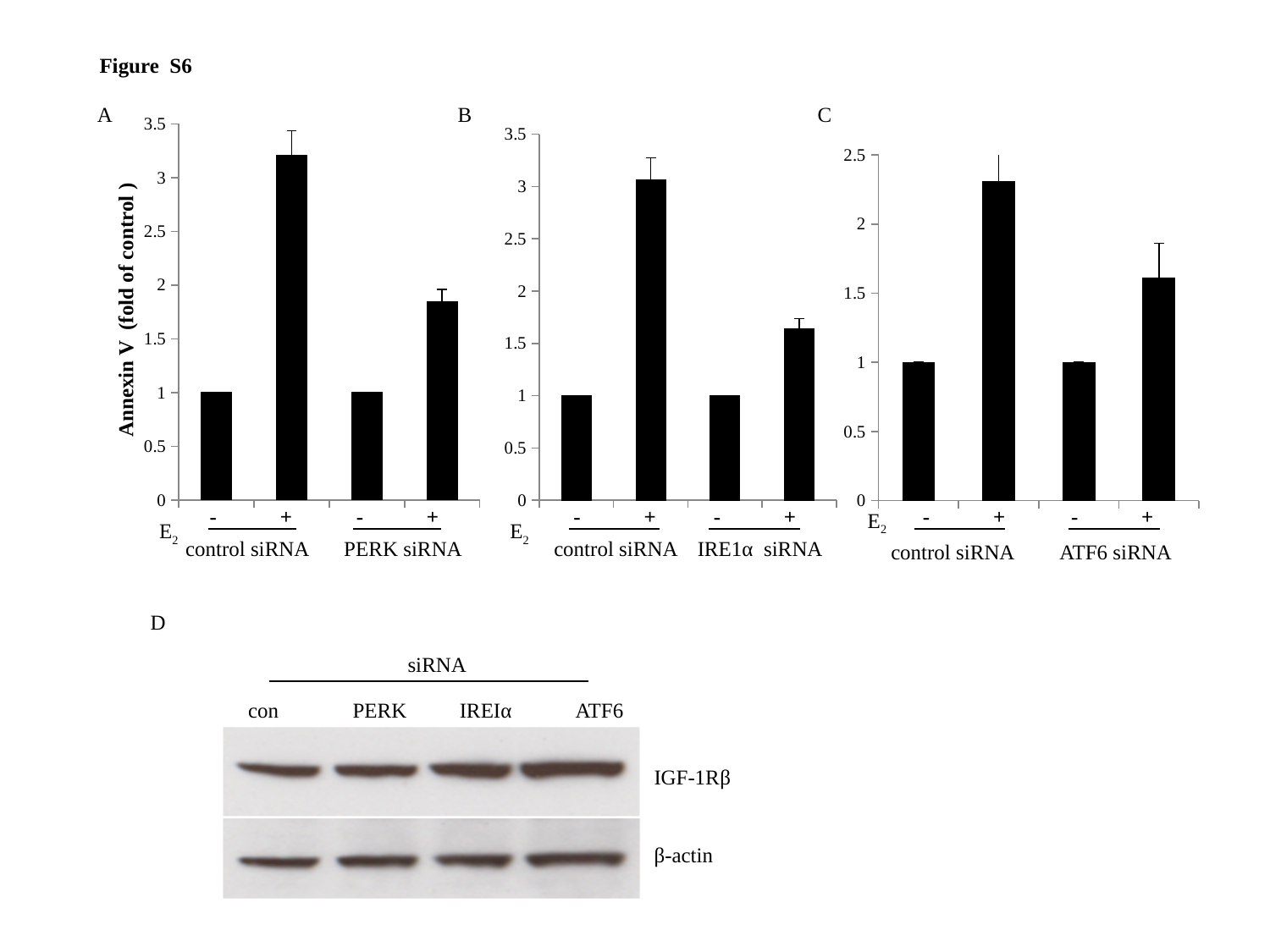
What kind of chart is chart A? bar chart In chart B, which is larger: the E2 + bar for control siRNA or the E2 + bar for IRE1α siRNA? control siRNA In chart C, is the value for ATF6 siRNA with E2 + greater or less than 2? less In chart A, is the value for PERK siRNA with E2 + greater or less than 2? less In chart C, what is the value for control siRNA with E2 -? 1 In chart A, which bar is the highest? control siRNA, E2 + What is the y-axis label of chart A? Annexin V (fold of control) In chart C, which bar is the highest? control siRNA, E2 + How many bars are plotted in chart B? 4 In chart B, is the value for IRE1α siRNA with E2 + greater or less than 1.5? greater What is the maximum value shown on the y-axis of chart C? 2.5